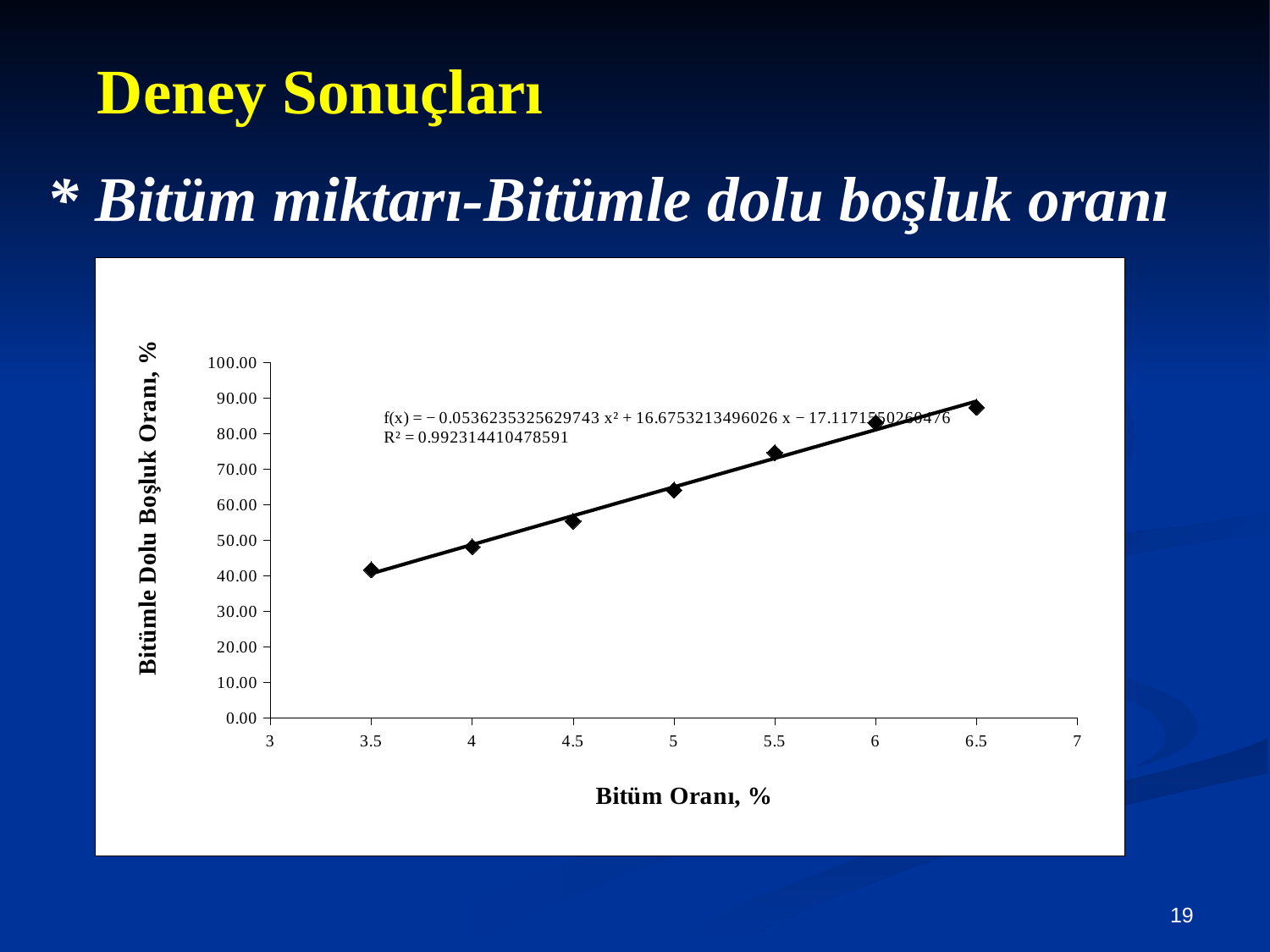
Is the value for Bitüm Oranı 6.5 greater or less than 90.00? less What R² value is printed on the chart? 0.992314410478591 What is the title of the x axis of the chart? Bitüm Oranı, % Do the plotted values rise or fall as Bitüm Oranı increases along the x axis? rise Is the value for Bitüm Oranı 4.5 greater or less than 50.00? greater Is the value for Bitüm Oranı 5 greater or less than 60.00? greater At which Bitüm Oranı value is the plotted Bitümle Dolu Boşluk Oranı highest? 6.5 What kind of chart is shown on the slide? scatter plot At which Bitüm Oranı value is the plotted Bitümle Dolu Boşluk Oranı lowest? 3.5 How many data points are plotted on the chart? 7 Which has the larger plotted value: Bitüm Oranı 4 or Bitüm Oranı 5? 5